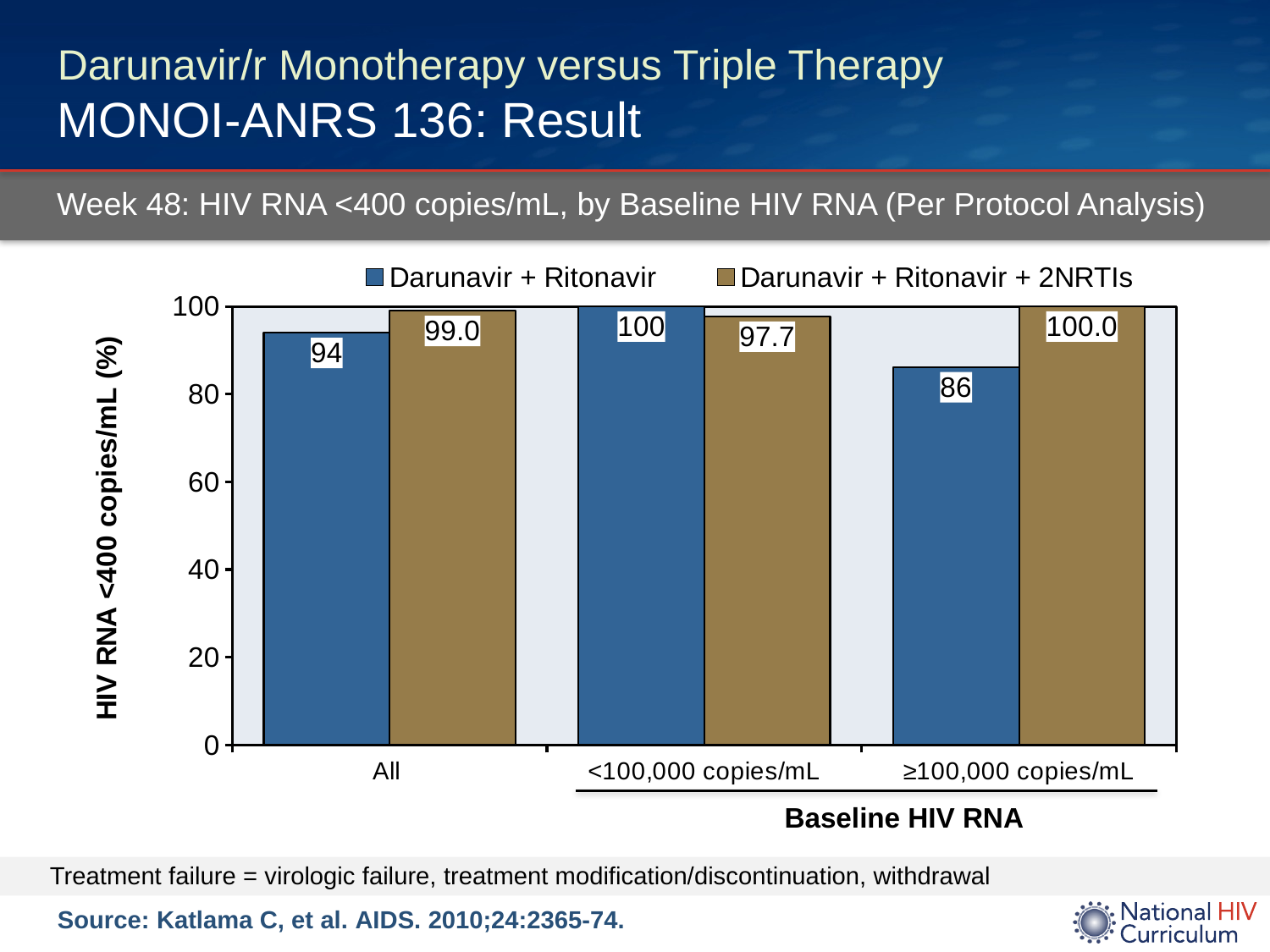
How many series does the legend list? 2 What kind of chart is shown on the slide? Bar chart How many categories are shown on the x axis? 3 What is the label of the y axis? HIV RNA <400 copies/mL (%) What is the difference between the Darunavir + Ritonavir + 2NRTIs and Darunavir + Ritonavir values in the ≥100,000 copies/mL category? 14 What is the value for Darunavir + Ritonavir + 2NRTIs in the All category? 99.0 Is the value for Darunavir + Ritonavir in the ≥100,000 copies/mL category greater or less than 80? greater What is the value for Darunavir + Ritonavir in the All category? 94 In the <100,000 copies/mL category, which series has the larger value: Darunavir + Ritonavir or Darunavir + Ritonavir + 2NRTIs? Darunavir + Ritonavir Which baseline HIV RNA category has the lowest value for Darunavir + Ritonavir? ≥100,000 copies/mL What is the value for Darunavir + Ritonavir + 2NRTIs in the ≥100,000 copies/mL category? 100.0 What is the value for Darunavir + Ritonavir in the <100,000 copies/mL category? 100